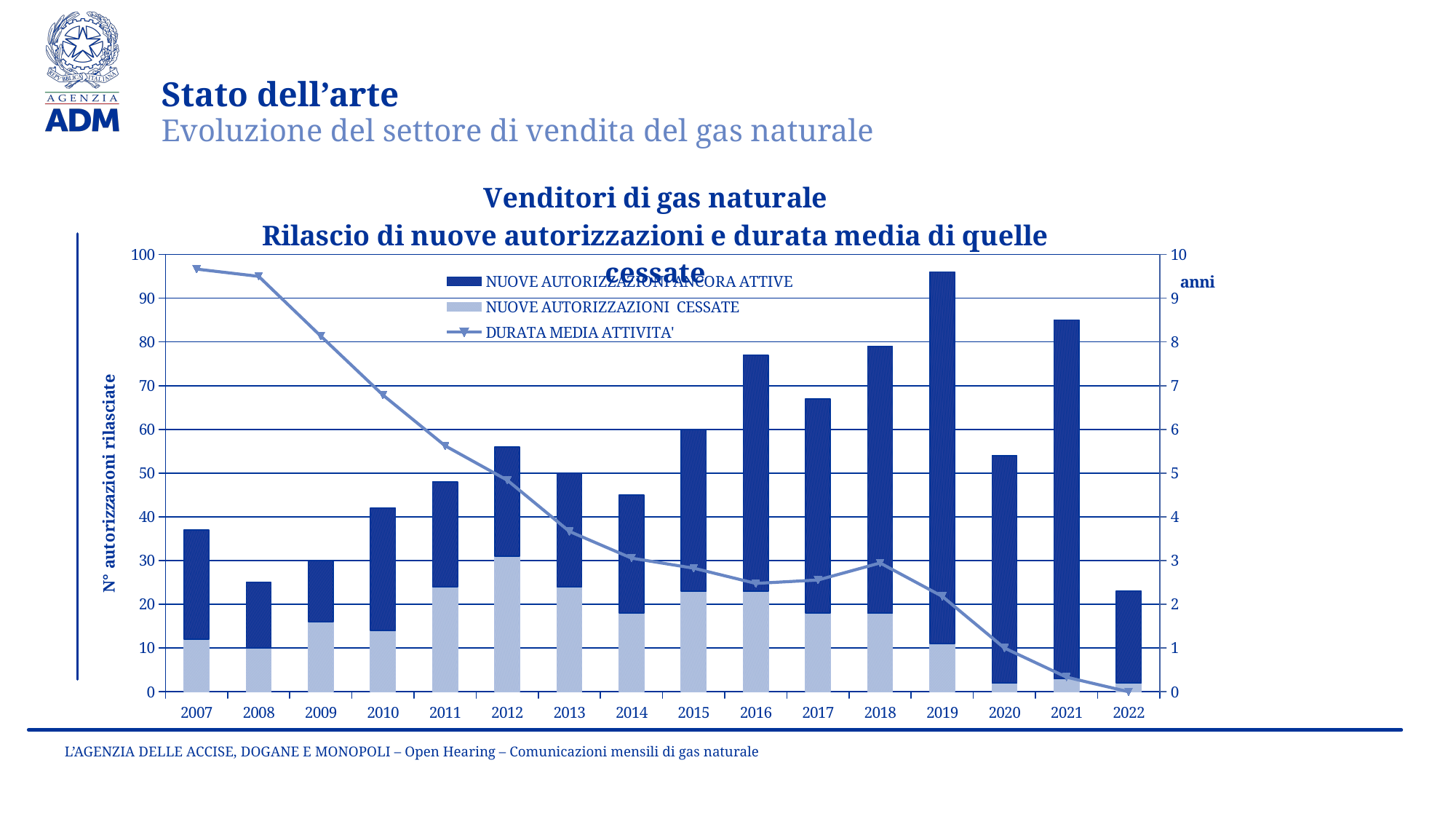
Is the total bar for 2019 greater or less than 90? greater Is the total bar for 2022 greater or less than 30? less Which year has the tallest total bar? 2019 Is the DURATA MEDIA ATTIVITA' value for 2007 greater or less than 9 anni? greater How many series does the legend list? 3 How many years are shown on the x axis? 16 What is the label of the right-hand vertical axis? anni What kind of chart is shown on the slide? A bar chart combined with a line Which year has the taller total bar, 2020 or 2021? 2021 Does the DURATA MEDIA ATTIVITA' line generally rise or fall from 2007 to 2022? fall